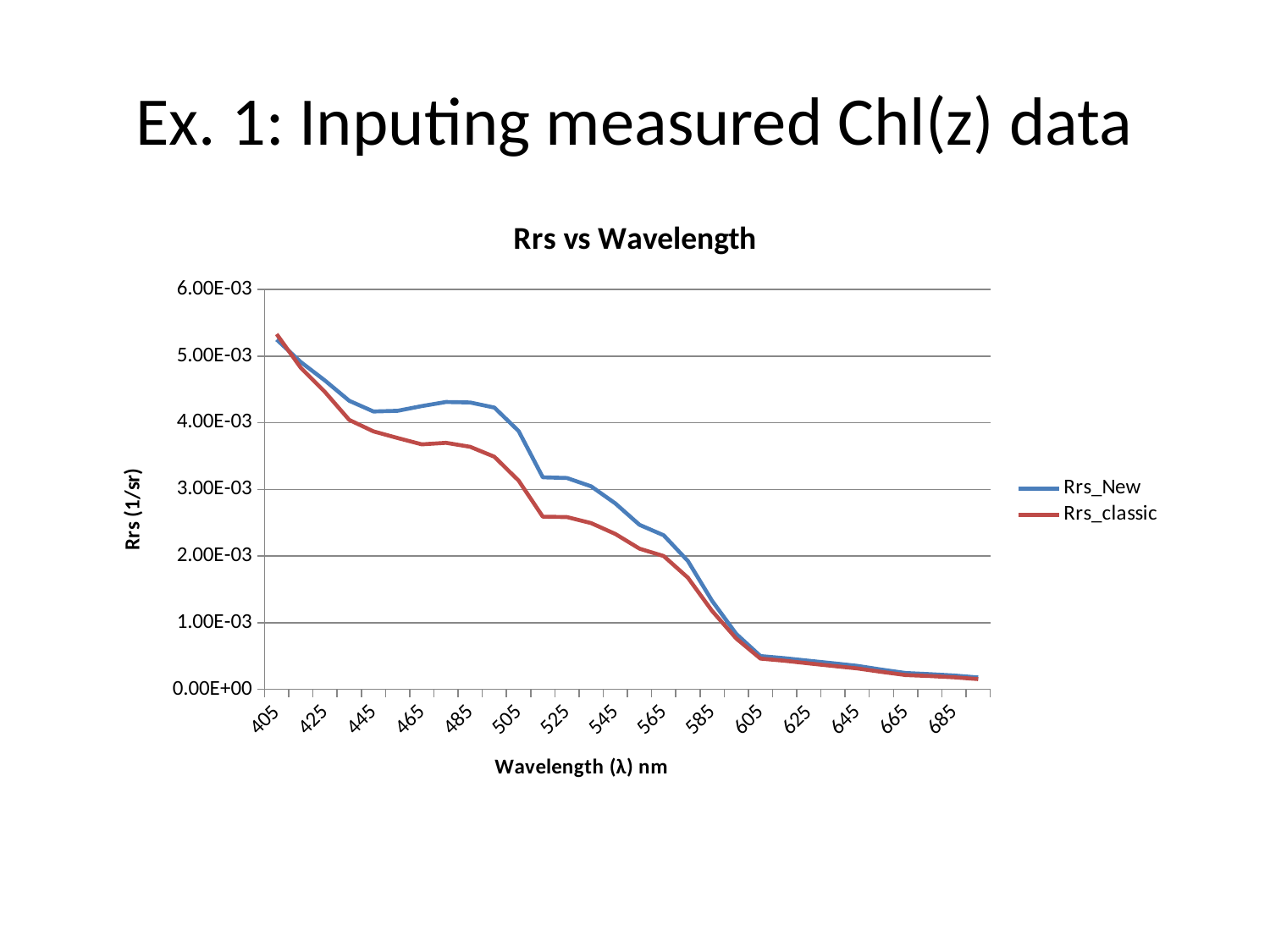
Is the Rrs_classic value at 485 nm greater or less than 4.00E-03? less Is the Rrs_New value at 525 nm greater or less than 3.00E-03? greater How many series does the legend list? 2 What is the title of the chart? Rrs vs Wavelength Which series is drawn in red? Rrs_classic At 525 nm, which series has the larger value, Rrs_New or Rrs_classic? Rrs_New Do the Rrs_New values generally rise or fall as wavelength increases? fall Is the Rrs_New value at 605 nm greater or less than 1.00E-03? less What kind of chart is shown on the slide? line chart At 485 nm, which series has the larger value, Rrs_New or Rrs_classic? Rrs_New